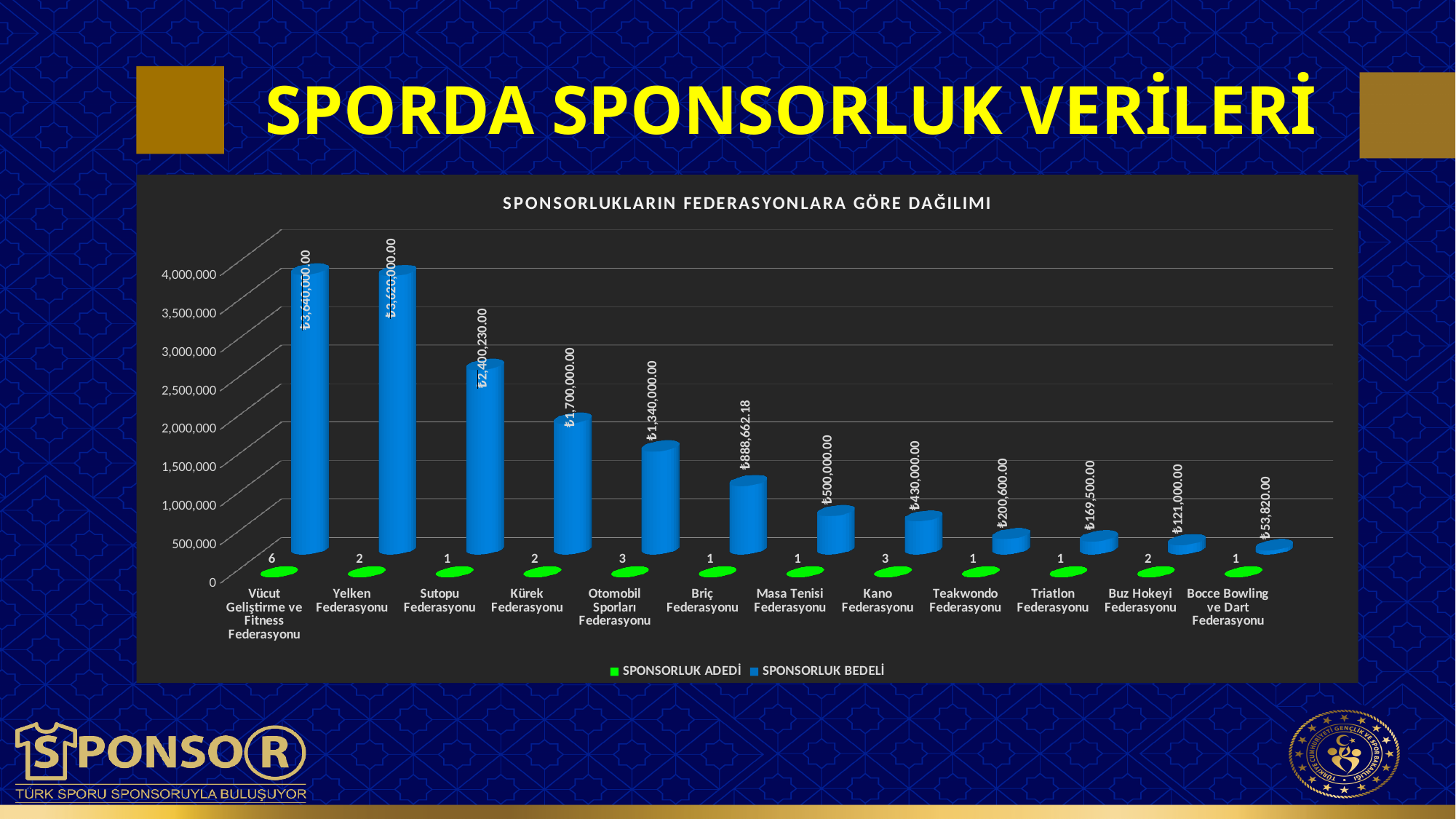
Which has a larger SPONSORLUK BEDELİ, Masa Tenisi Federasyonu or Kano Federasyonu? Masa Tenisi Federasyonu Do the SPONSORLUK BEDELİ values rise or fall from left to right along the x axis? Fall What is the SPONSORLUK BEDELİ value for Teakwondo Federasyonu? ₺200,600.00 What is the SPONSORLUK ADEDİ value for Kano Federasyonu? 3 What is the difference in SPONSORLUK BEDELİ between Kürek Federasyonu and Otomobil Sporları Federasyonu? ₺360,000.00 What is the SPONSORLUK BEDELİ value for Sutopu Federasyonu? ₺2,400,230.00 How many series does the chart legend list? 2 What kind of chart is shown on the slide? Bar chart How many federations are shown on the x axis of the chart? 12 What is the SPONSORLUK BEDELİ value for Briç Federasyonu? ₺888,662.18 Which federation has the highest SPONSORLUK ADEDİ? Vücut Geliştirme ve Fitness Federasyonu Which federation has the lowest SPONSORLUK BEDELİ? Bocce Bowling ve Dart Federasyonu